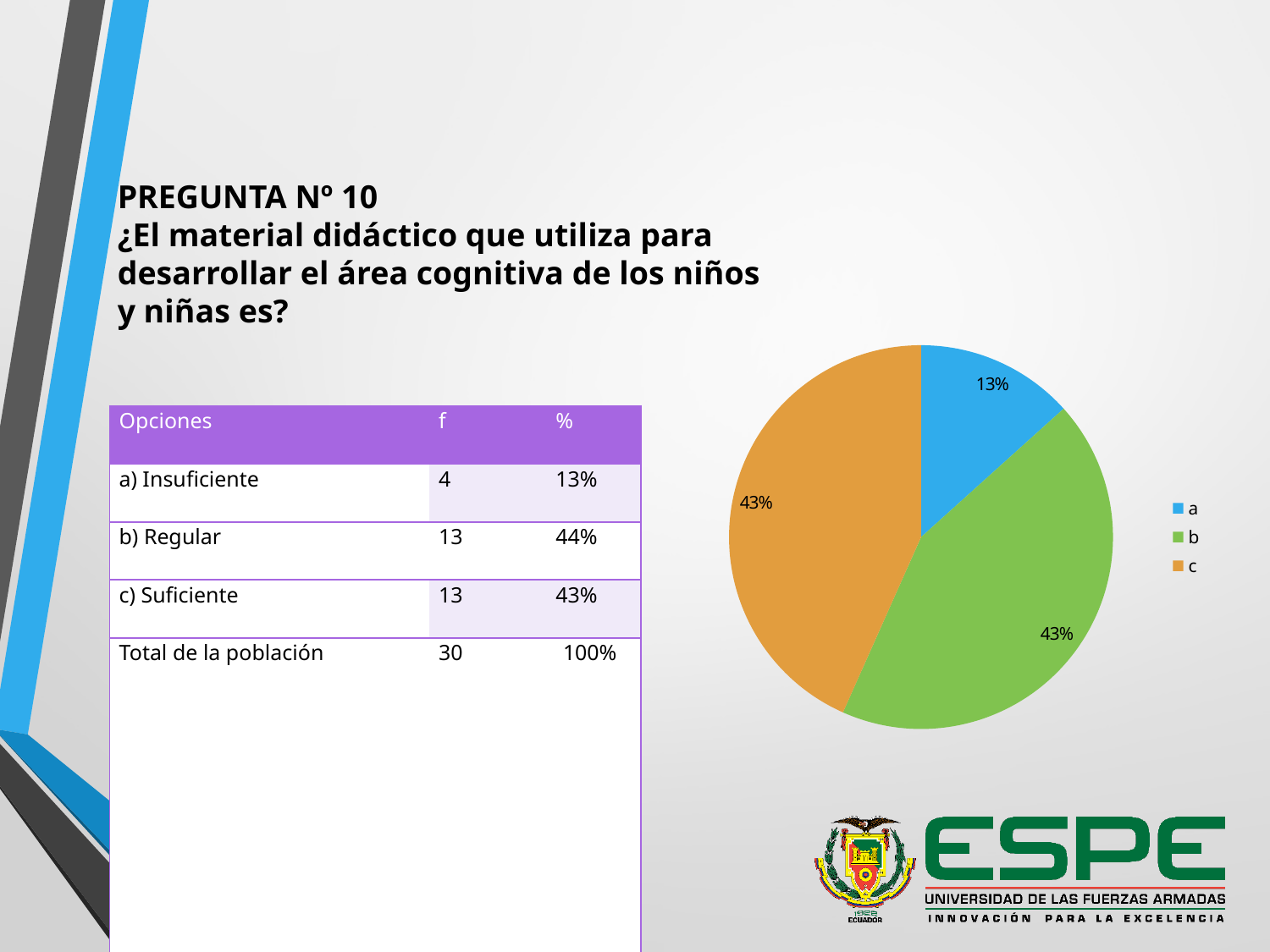
What colour is slice c in the pie chart? orange How many slices does the pie chart have? 3 Which slice of the pie chart is the smallest? a What share of the pie does slice a represent? 13% What kind of chart is shown on the slide? pie chart What is the difference in percentage points between slice c and slice a in the pie chart? 30 What percentage is shown for slice b in the pie chart? 43% What percentage is shown for slice c in the pie chart? 43% Which is larger in the pie chart, slice a or slice b? b What are the legend entries of the pie chart? a, b, c How many entries does the pie chart's legend list? 3 What percentage is shown for slice a in the pie chart? 13%